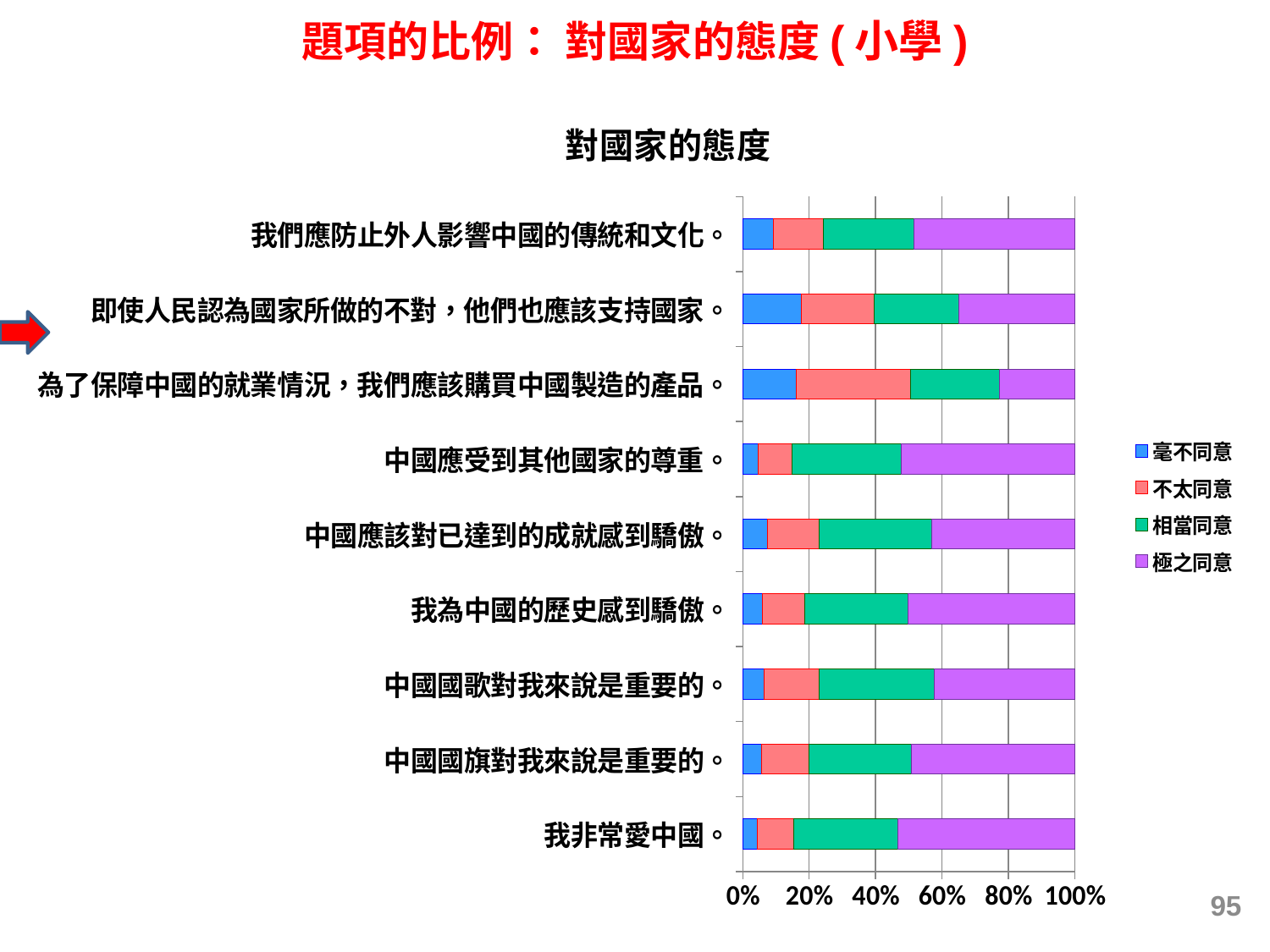
Which statement has the smallest 極之同意 share? 為了保障中國的就業情況，我們應該購買中國製造的產品。 Which has the larger 毫不同意 share: 我們應防止外人影響中國的傳統和文化。 or 我非常愛中國。? 我們應防止外人影響中國的傳統和文化。 Which statement has the largest 不太同意 share? 為了保障中國的就業情況，我們應該購買中國製造的產品。 How many series does the legend list? 4 How many statements (categories) are plotted in the chart? 9 What kind of chart is shown on the slide? Stacked bar chart Is the combined share of 毫不同意 and 不太同意 for 為了保障中國的就業情況，我們應該購買中國製造的產品。 greater or less than 40%? greater Is the 極之同意 share for 我非常愛中國。 greater or less than 40%? greater What is the title of the chart? 對國家的態度 Which legend entry is shown in purple? 極之同意 Is the 毫不同意 share for 我非常愛中國。 greater or less than 20%? less Which has the larger 極之同意 share: 我非常愛中國。 or 即使人民認為國家所做的不對，他們也應該支持國家。? 我非常愛中國。